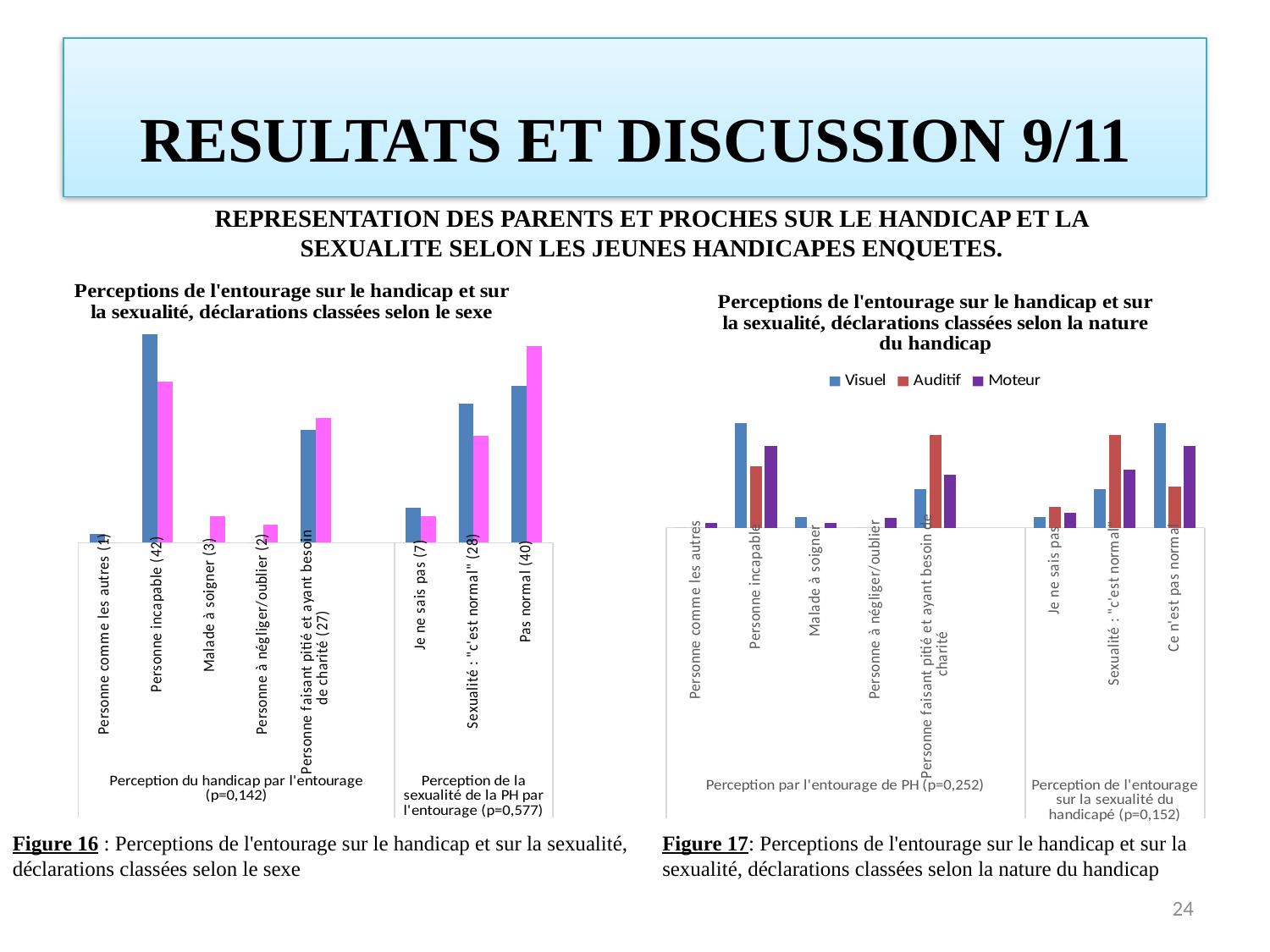
What kind of chart is the left chart, 'Perceptions de l'entourage sur le handicap et sur la sexualité, déclarations classées selon le sexe'? Bar chart How many series does the legend of the right chart (Figure 17) list? 3 In the left chart (Figure 16), for 'Personne incapable (42)', is the blue bar or the pink bar taller? Blue In the left chart (Figure 16), which category has the tallest bar overall? Personne incapable (42) In the right chart (Figure 17), for 'Je ne sais pas', is the Visuel bar or the Auditif bar taller? Auditif In the left chart (Figure 16), for 'Pas normal (40)', is the blue bar or the pink bar taller? Pink In the right chart (Figure 17), which series has the shortest bar for 'Ce n'est pas normal'? Auditif In the right chart (Figure 17), which series has the tallest bar for 'Personne incapable'? Visuel What p-value is shown for the group 'Perception de la sexualité de la PH par l'entourage' in the left chart (Figure 16)? p=0,577 What are the legend entries of the right chart (Figure 17)? Visuel, Auditif, Moteur In the right chart (Figure 17), which series has the tallest bar for 'Personne faisant pitié et ayant besoin de charité'? Auditif How many categories are shown on the x axis of the left chart (Figure 16)? 8